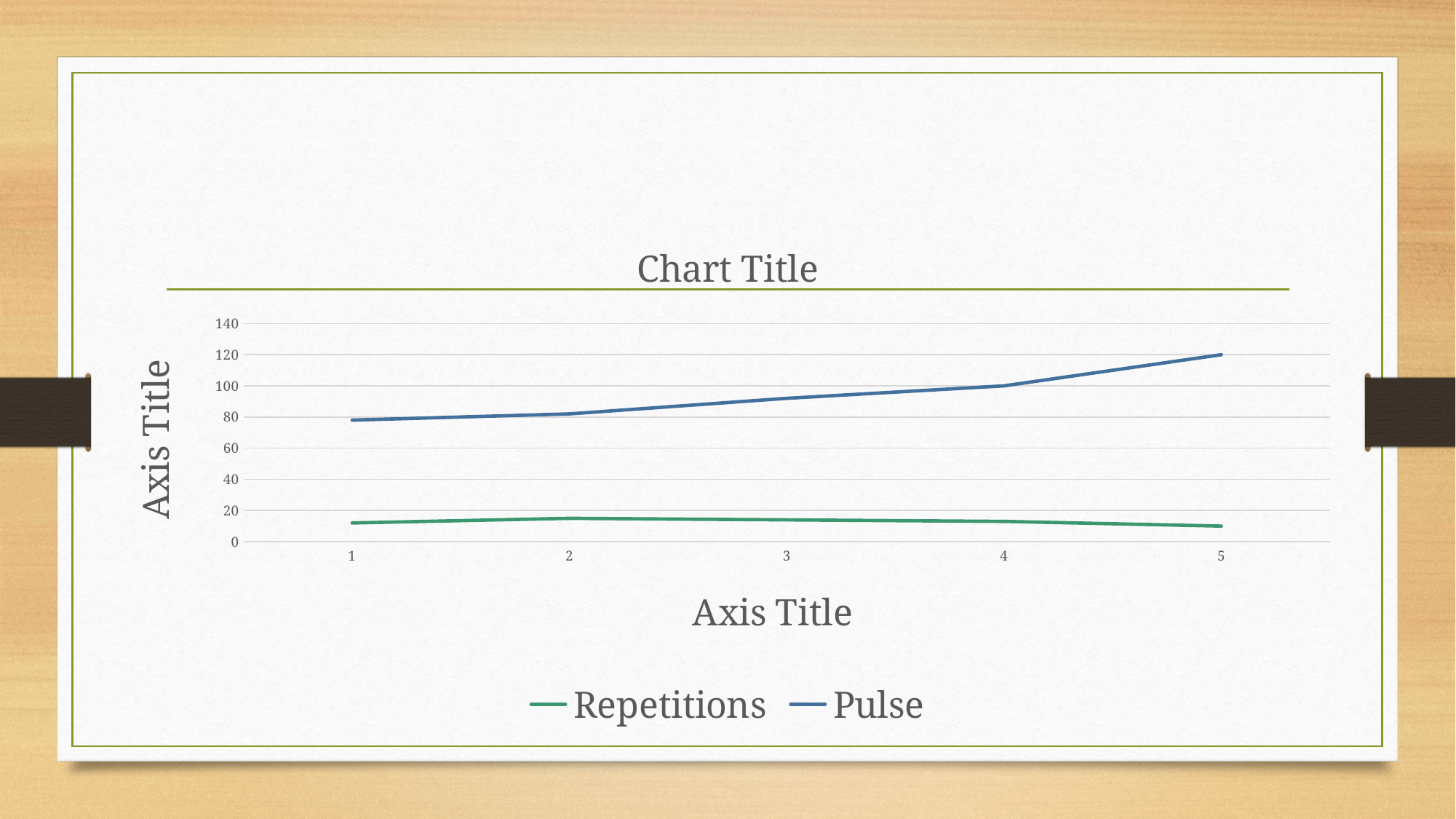
At which x value does the Pulse series reach its highest point? 5 What are the names of the series in the legend? Repetitions and Pulse What is the title of the chart? Chart Title What is the Pulse value at x = 5? 120 How many series does the legend list? 2 Is the Pulse value at x = 1 greater or less than 100? less Which series has the higher value at x = 3, Repetitions or Pulse? Pulse Does the Pulse series rise or fall from x = 1 to x = 5? rise Is the Repetitions value at x = 3 greater or less than 40? less Is the Pulse value at x = 1 greater or less than 60? greater How many points are plotted along the x axis for each series? 5 What kind of chart is shown on the slide? line chart